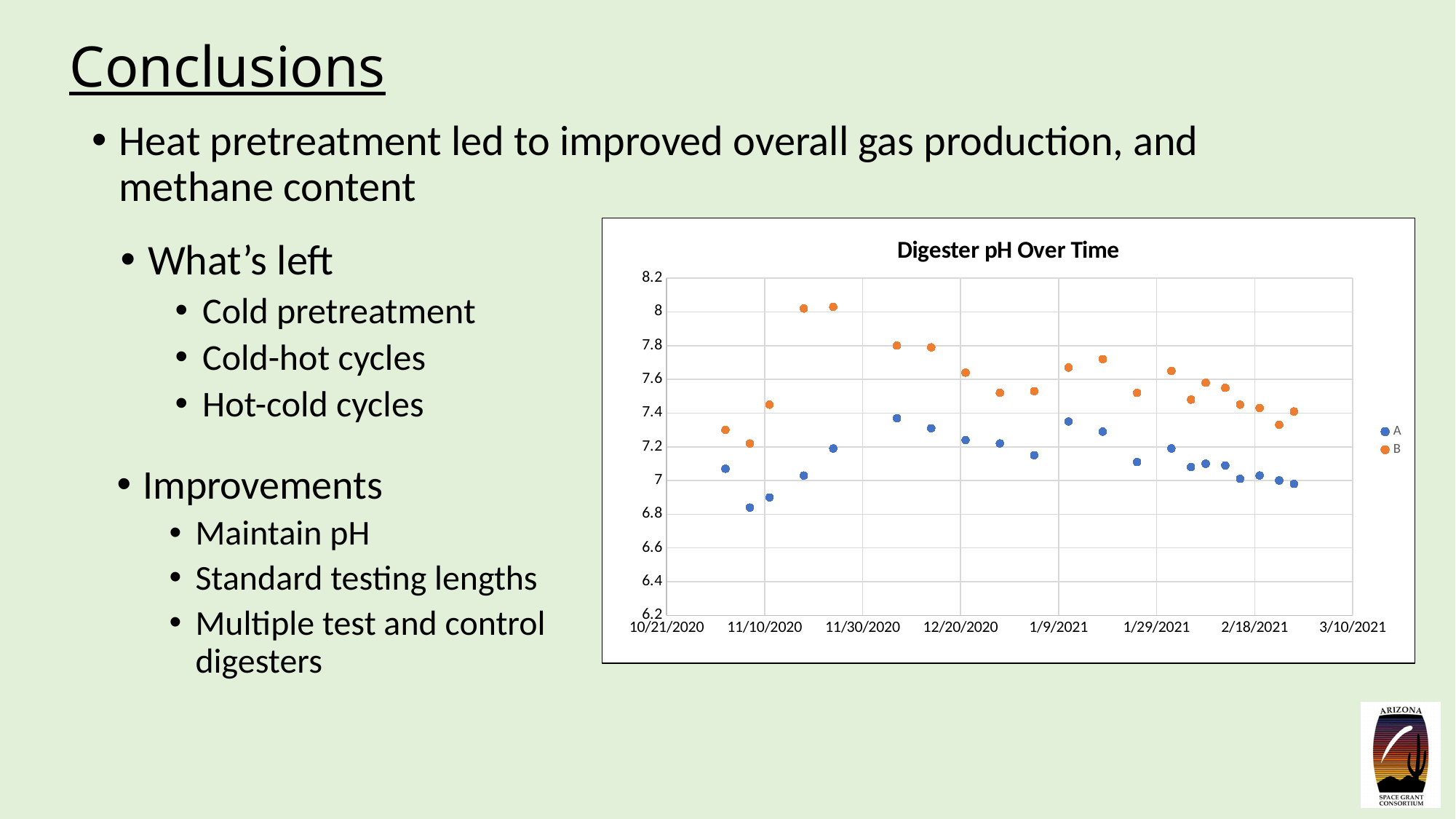
Which series, A or B, contains the highest pH value on the chart? B Is the lowest value for series A greater or less than 7? less How many series does the chart's legend list? 2 What kind of chart is shown on the slide? Scatter chart Which series, A or B, contains the lowest pH value on the chart? A What are the names of the two series in the legend? A and B Is the highest value for series B greater or less than 7.8? greater Do the values for series B rise or fall between 1/29/2021 and the end of the data? fall Which series generally has higher pH values, A or B? B What is the title of the chart? Digester pH Over Time Is the highest value for series A greater or less than 7.6? less